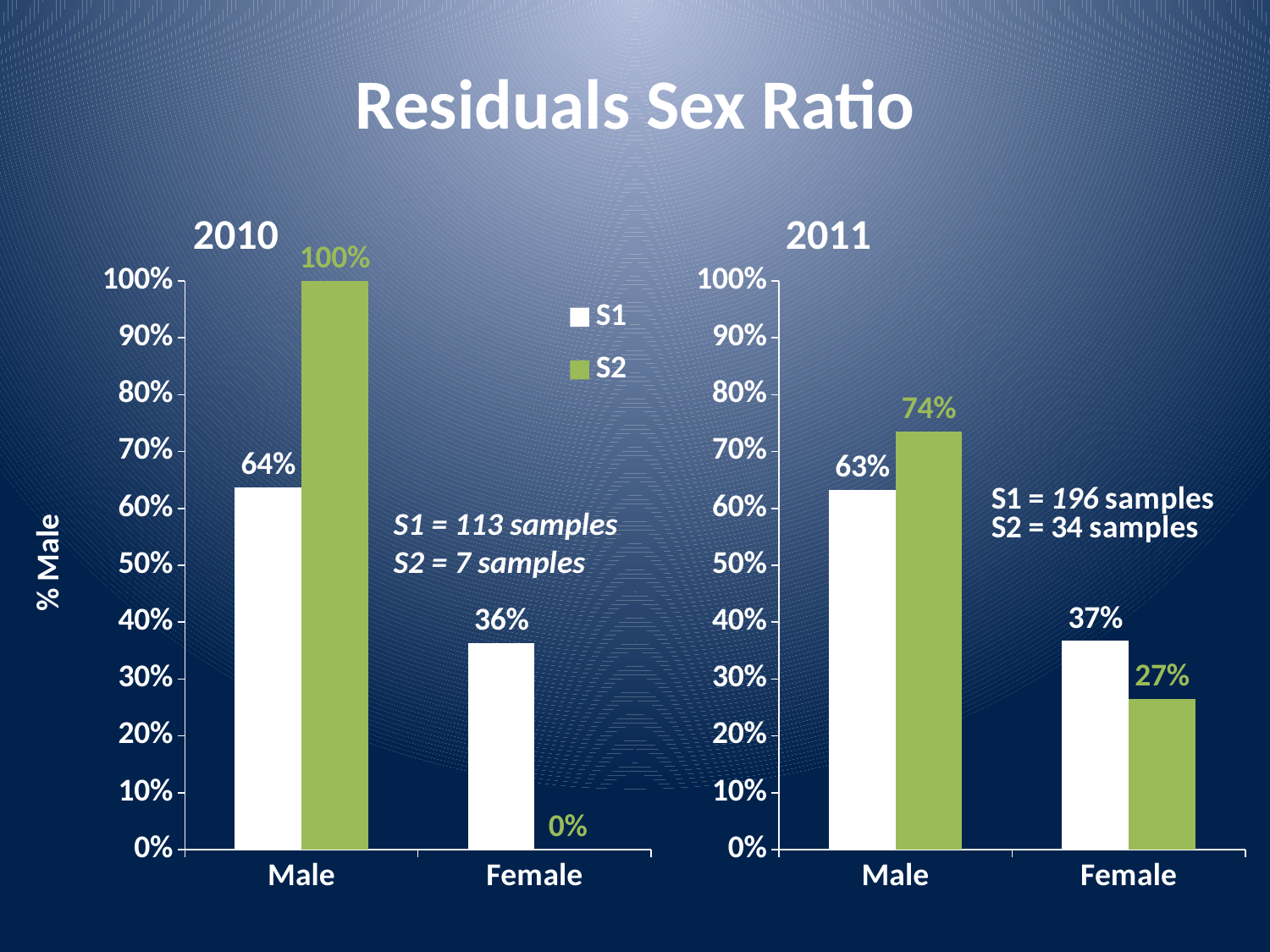
In the 2010 chart, what is the value for S2 in the Female category? 0% In the 2010 chart, what is the value for S2 in the Male category? 100% In the 2010 chart, what is the value for S1 in the Male category? 64% What is the label on the vertical axis of the 2010 chart? % Male In the 2010 chart, which bar has the highest value? S2 Male In the 2011 chart, what is the value for S2 in the Male category? 74% What kind of chart is the 2011 chart? bar chart In the 2010 chart, what is the difference between the S1 values for Male and Female? 28% In the 2011 chart, which is larger for the Female category, S1 or S2? S1 In the 2011 chart, what is the difference between the S2 values for Male and Female? 47% In the 2011 chart, what is the value for S1 in the Female category? 37% How many series does the legend list? 2